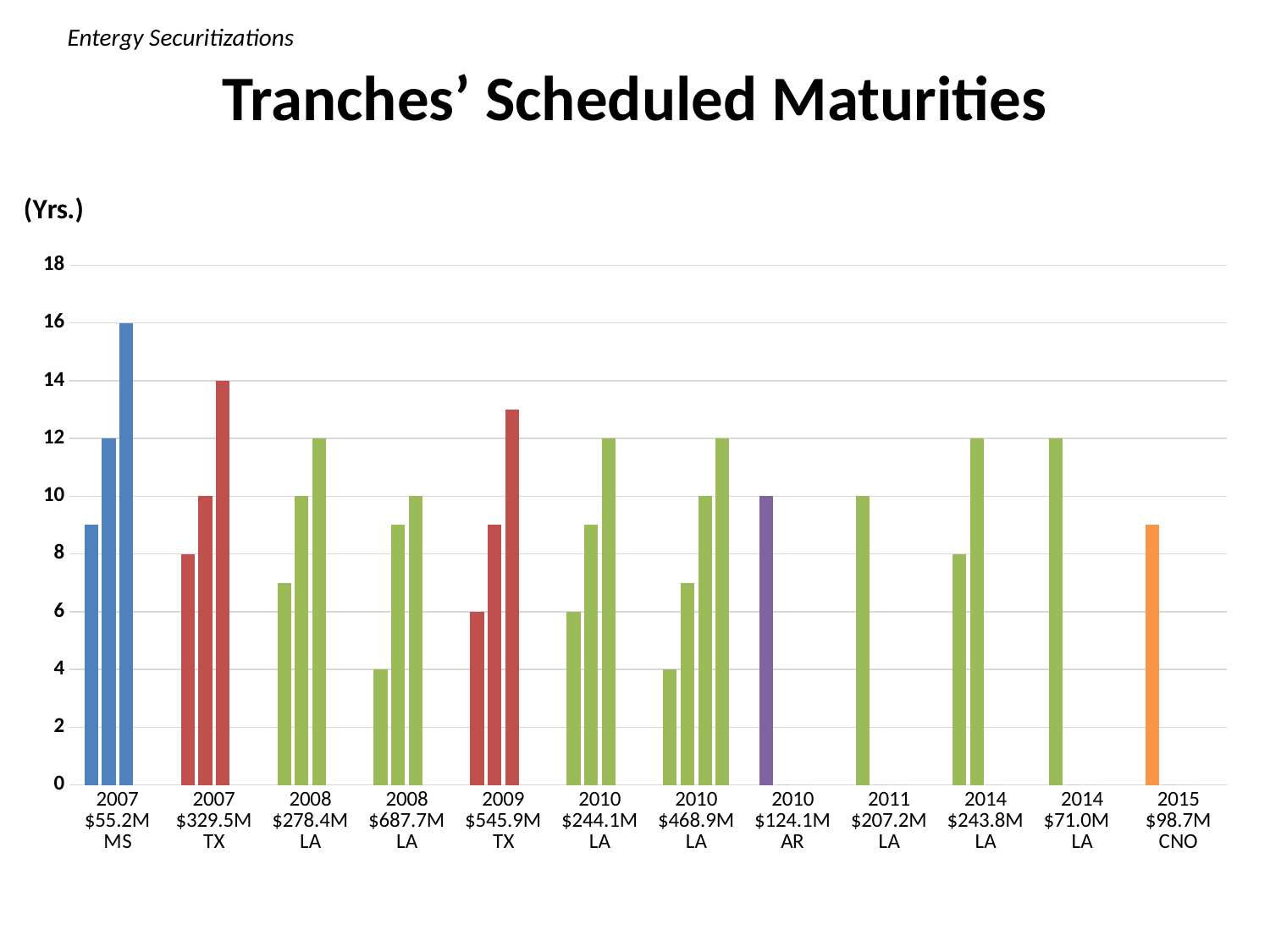
What is the value of the bar for 2014 $71.0M LA? 12 Which category contains the tallest bar on the chart? 2007 $55.2M MS What is the value of the bar for 2011 $207.2M LA? 10 Is the tallest bar in the 2009 $545.9M TX group greater or less than 12? greater What type of chart is shown on the slide? bar chart What is the value of the tallest bar in the 2007 $55.2M MS group? 16 What is the value of the tallest bar in the 2007 $329.5M TX group? 14 How many bars are in the 2010 $468.9M LA group? 4 How many securitization categories are shown along the x axis? 12 Which is larger, the bar for 2014 $71.0M LA or the bar for 2011 $207.2M LA? 2014 $71.0M LA What is the value of the bar for 2010 $124.1M AR? 10 Is the value of the bar for 2015 $98.7M CNO greater or less than 10? less